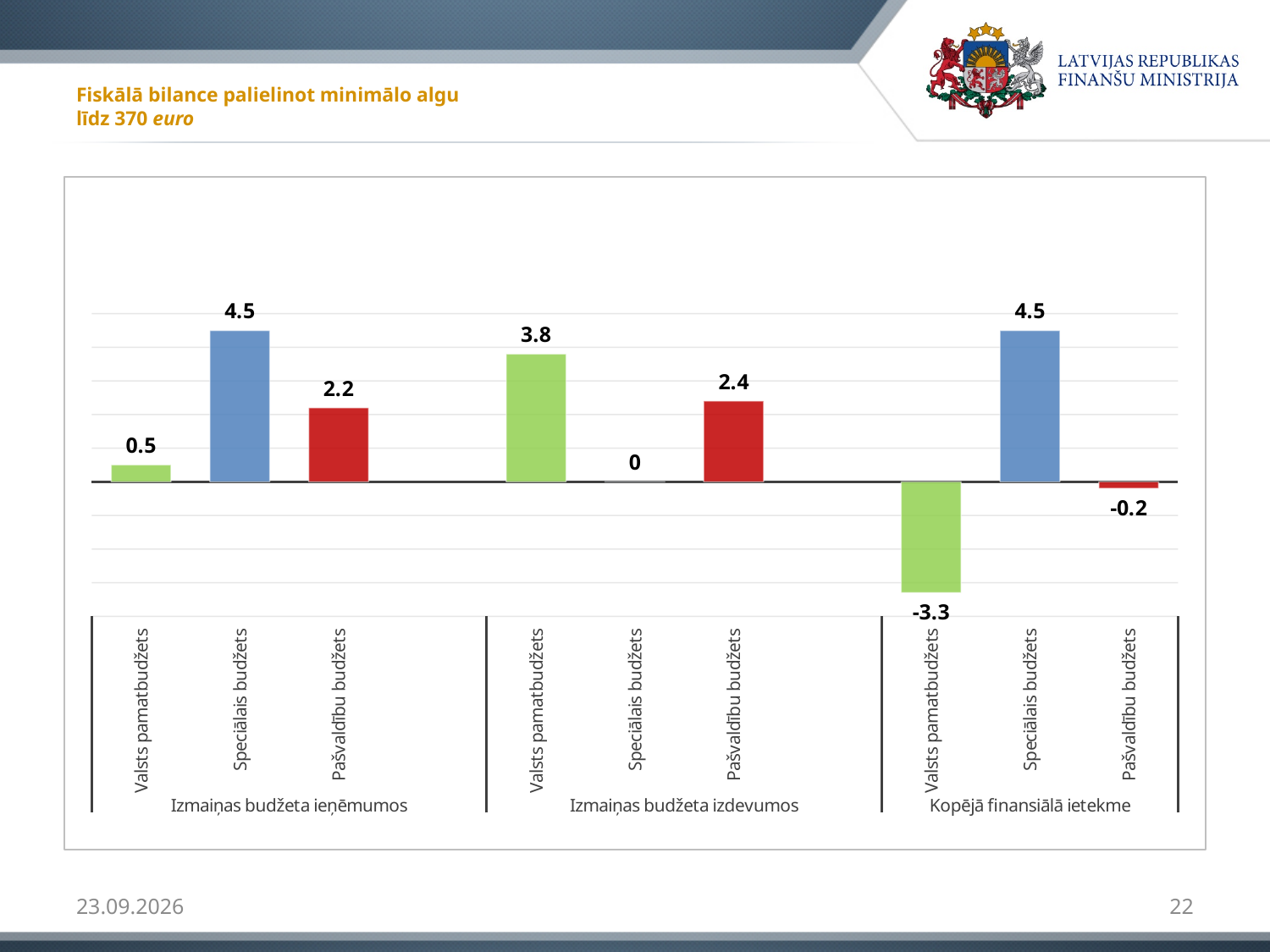
What is the value for Speciālais budžets under Izmaiņas budžeta ieņēmumos? 4.5 What is the value for Pašvaldību budžets under Kopējā finansiālā ietekme? -0.2 What is the value for Speciālais budžets under Izmaiņas budžeta izdevumos? 0 How many bars are plotted in the chart? 9 What is the value for Valsts pamatbudžets under Kopējā finansiālā ietekme? -3.3 What is the difference between Pašvaldību budžets under Izmaiņas budžeta izdevumos and under Izmaiņas budžeta ieņēmumos? 0.2 Which bar has the lowest value in the chart? Valsts pamatbudžets (Kopējā finansiālā ietekme) Within the Izmaiņas budžeta ieņēmumos group, which budget has the highest value? Speciālais budžets How many category groups are shown on the x axis? 3 Which is larger: Valsts pamatbudžets under Izmaiņas budžeta ieņēmumos or under Izmaiņas budžeta izdevumos? Izmaiņas budžeta izdevumos What is the value for Valsts pamatbudžets under Izmaiņas budžeta izdevumos? 3.8 What type of chart is shown on the slide? Bar chart